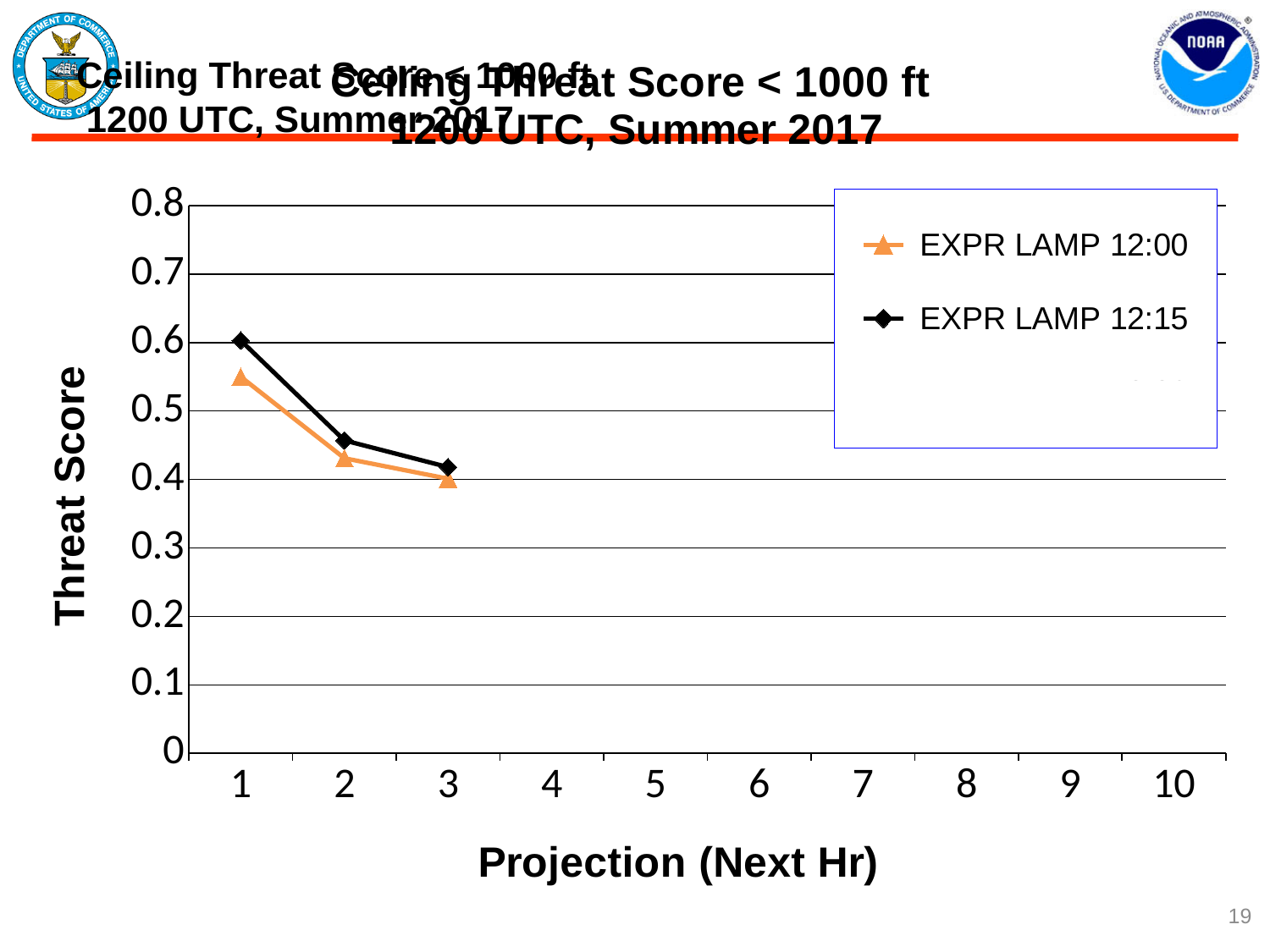
Do the threat scores for EXPR LAMP 12:15 rise or fall from projection 1 to projection 3? Fall Is the threat score for EXPR LAMP 12:00 at projection 2 greater or less than 0.5? less At which projection hour does EXPR LAMP 12:15 reach its highest threat score? 1 Is the threat score for EXPR LAMP 12:15 at projection 1 greater or less than 0.5? greater What is the label of the y axis? Threat Score What are the two series named in the legend? EXPR LAMP 12:00 and EXPR LAMP 12:15 What kind of chart is shown on the slide? Line chart At projection 1, which series has the higher threat score, EXPR LAMP 12:00 or EXPR LAMP 12:15? EXPR LAMP 12:15 Do the threat scores for EXPR LAMP 12:00 rise or fall as the projection hour increases from 1 to 3? Fall How many projection hours have plotted data points for the EXPR LAMP 12:15 series? 3 How many series does the legend list? 2 Is the threat score for EXPR LAMP 12:15 at projection 3 greater or less than 0.5? less